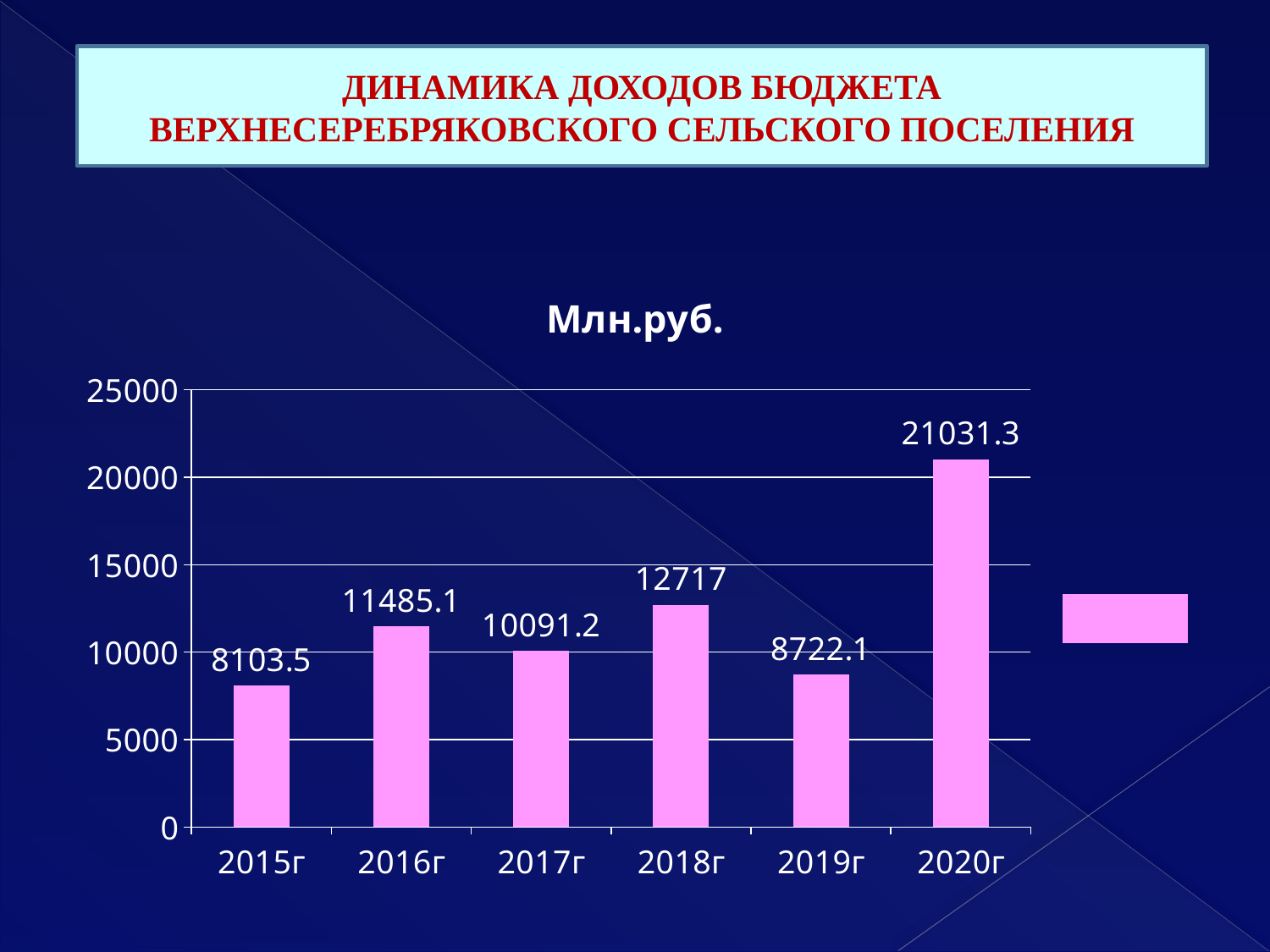
What is the value for 2018г? 12717 What is the difference between the values for 2018г and 2017г? 2625.8 How many years are shown on the x axis? 6 What is the value for 2015г? 8103.5 Which year has the highest value? 2020г Is the value for 2019г greater or less than 10000? less Which year has the lowest value? 2015г What is the value for 2020г? 21031.3 What is the difference between the values for 2020г and 2015г? 12927.8 Which is larger, the value for 2016г or the value for 2019г? 2016г Does the value rise or fall from 2018г to 2019г? fall What kind of chart is shown on the slide? bar chart